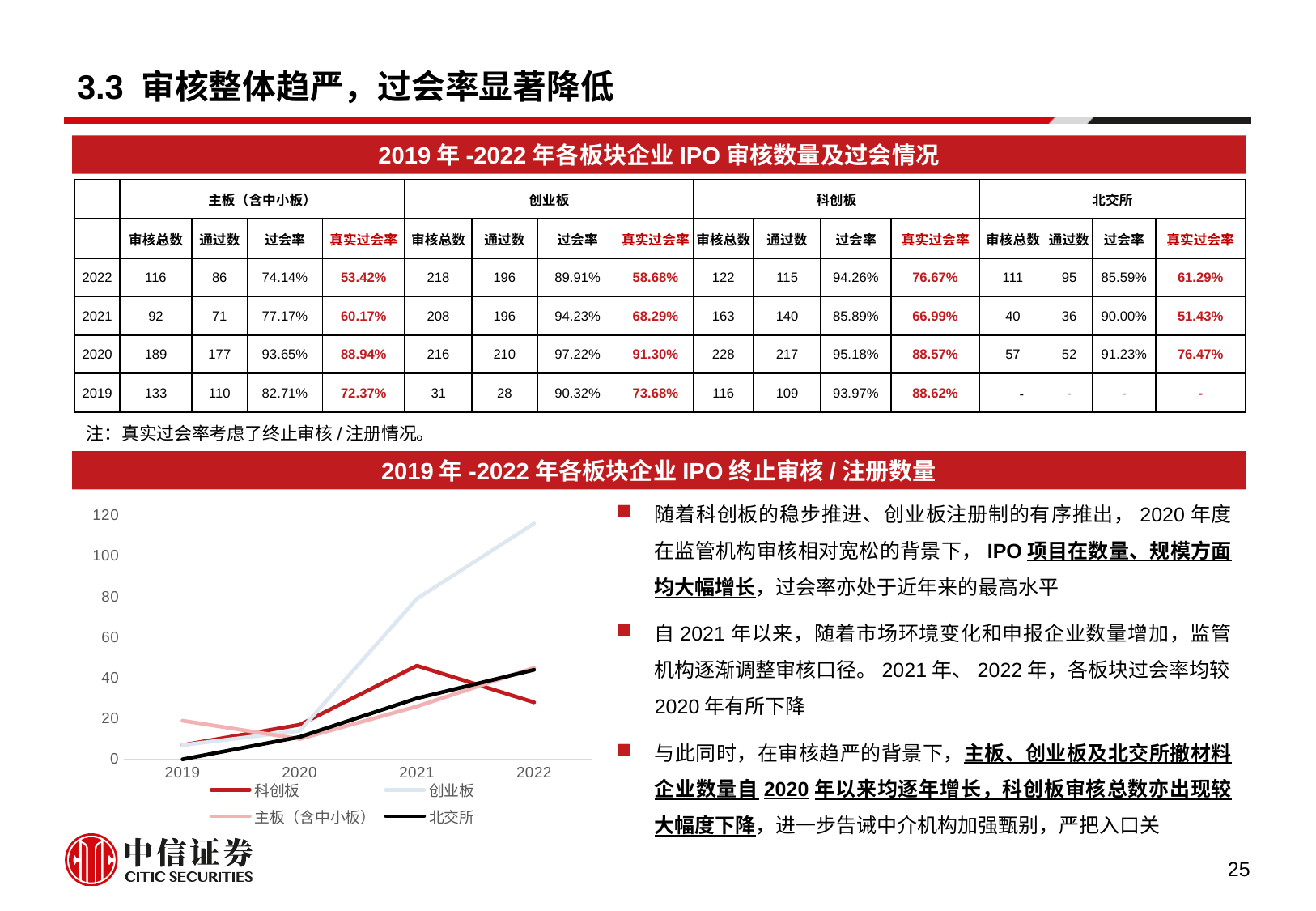
Is the value for 创业板 in 2022 greater or less than 100? greater How many years are shown on the x axis of the chart? 4 In 2021, which is larger: the value for 创业板 or the value for 科创板? 创业板 Does the value for 创业板 rise or fall from 2019 to 2022? rise Which series has the lowest value in 2022? 科创板 Is the value for 北交所 in 2021 greater or less than 40? less What kind of chart is shown on the slide? line chart What colour is the line for 北交所 in the chart? black Is the value for 科创板 in 2022 greater or less than 40? less Does the value for 科创板 rise or fall from 2021 to 2022? fall Which series has the highest value in 2022? 创业板 How many series does the chart legend list? 4